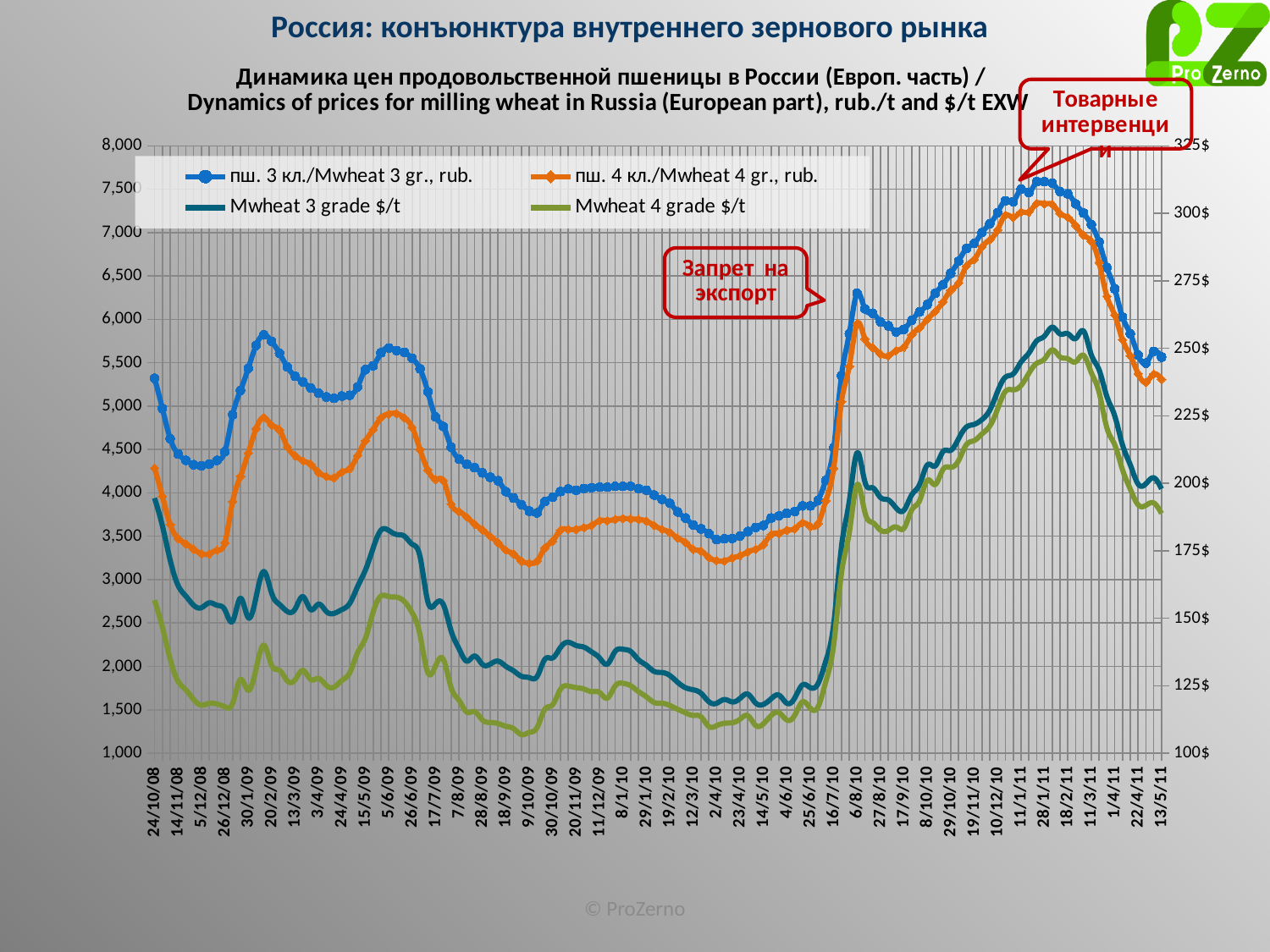
Does the value for пш. 4 кл./Mwheat 4 gr., rub. rise or fall between 28/1/11 and 22/4/11? fall Is the value for Mwheat 3 grade $/t at 28/1/11 greater or less than 250$? greater Is the value for пш. 3 кл./Mwheat 3 gr., rub. at 28/1/11 greater or less than 7,000? greater Is the value for пш. 4 кл./Mwheat 4 gr., rub. at 2/4/10 greater or less than 3,500? less Does the value for пш. 3 кл./Mwheat 3 gr., rub. rise or fall between 16/7/10 and 28/1/11? rise What text is in the callout pointing to the price jump around 16/7/10? Запрет на экспорт How many series does the legend list? 4 Which is higher at 28/1/11: пш. 3 кл./Mwheat 3 gr., rub. or пш. 4 кл./Mwheat 4 gr., rub.? пш. 3 кл./Mwheat 3 gr., rub. What kind of chart is shown on the slide? line chart Which series is shown in orange in the legend? пш. 4 кл./Mwheat 4 gr., rub.